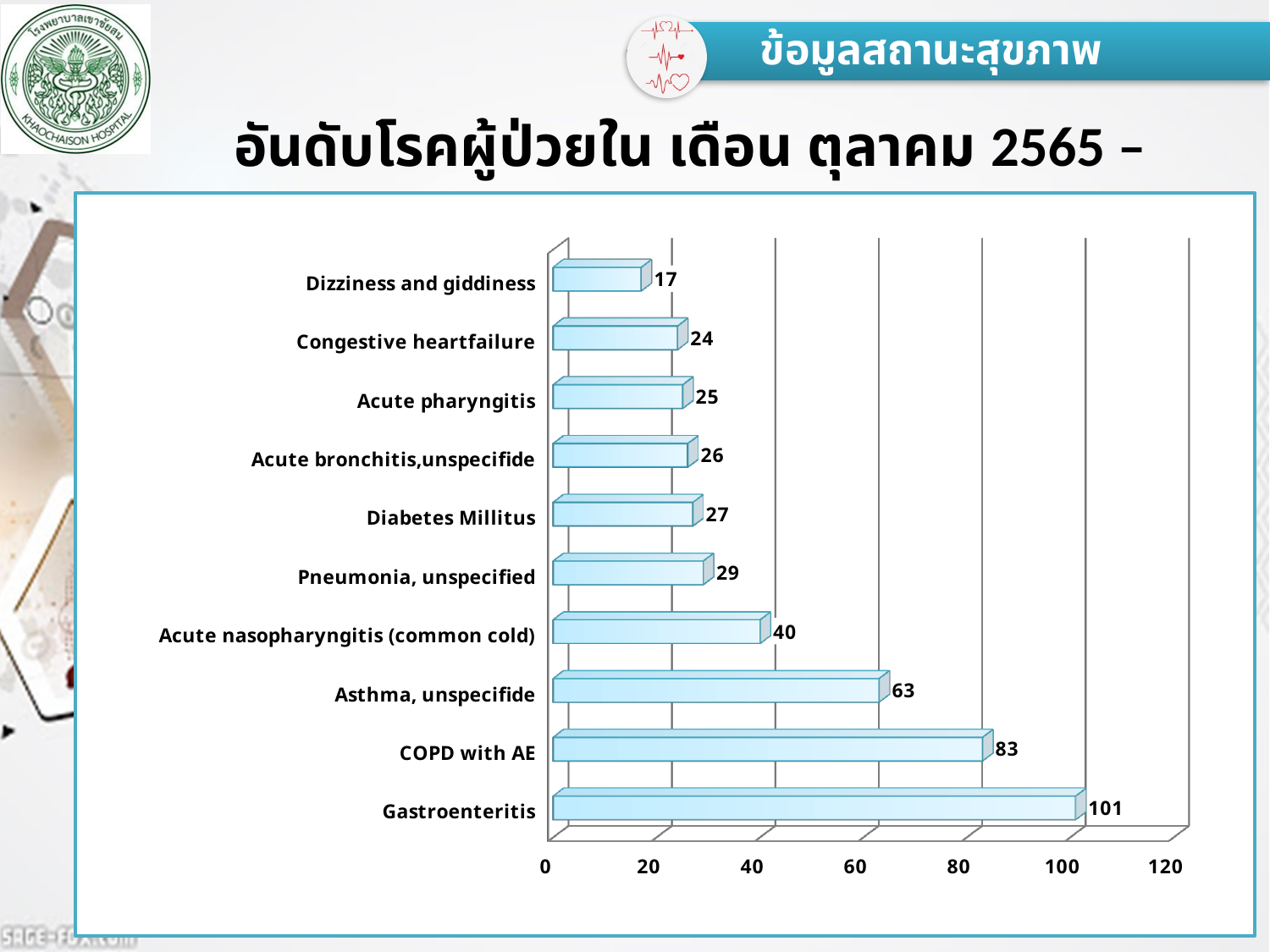
Which category has the highest value? Gastroenteritis How many categories are shown in the chart? 10 Which is larger, the value for Pneumonia, unspecified or the value for Diabetes Millitus? Pneumonia, unspecified What is the difference between the values for Gastroenteritis and COPD with AE? 18 What is the difference between the values for Asthma, unspecifide and Acute nasopharyngitis (common cold)? 23 What is the value for COPD with AE? 83 Is the value for COPD with AE greater or less than 80? greater What is the value for Dizziness and giddiness? 17 What is the value for Acute nasopharyngitis (common cold)? 40 What is the value for Gastroenteritis? 101 What kind of chart is shown on the slide? bar chart Which category has the lowest value? Dizziness and giddiness